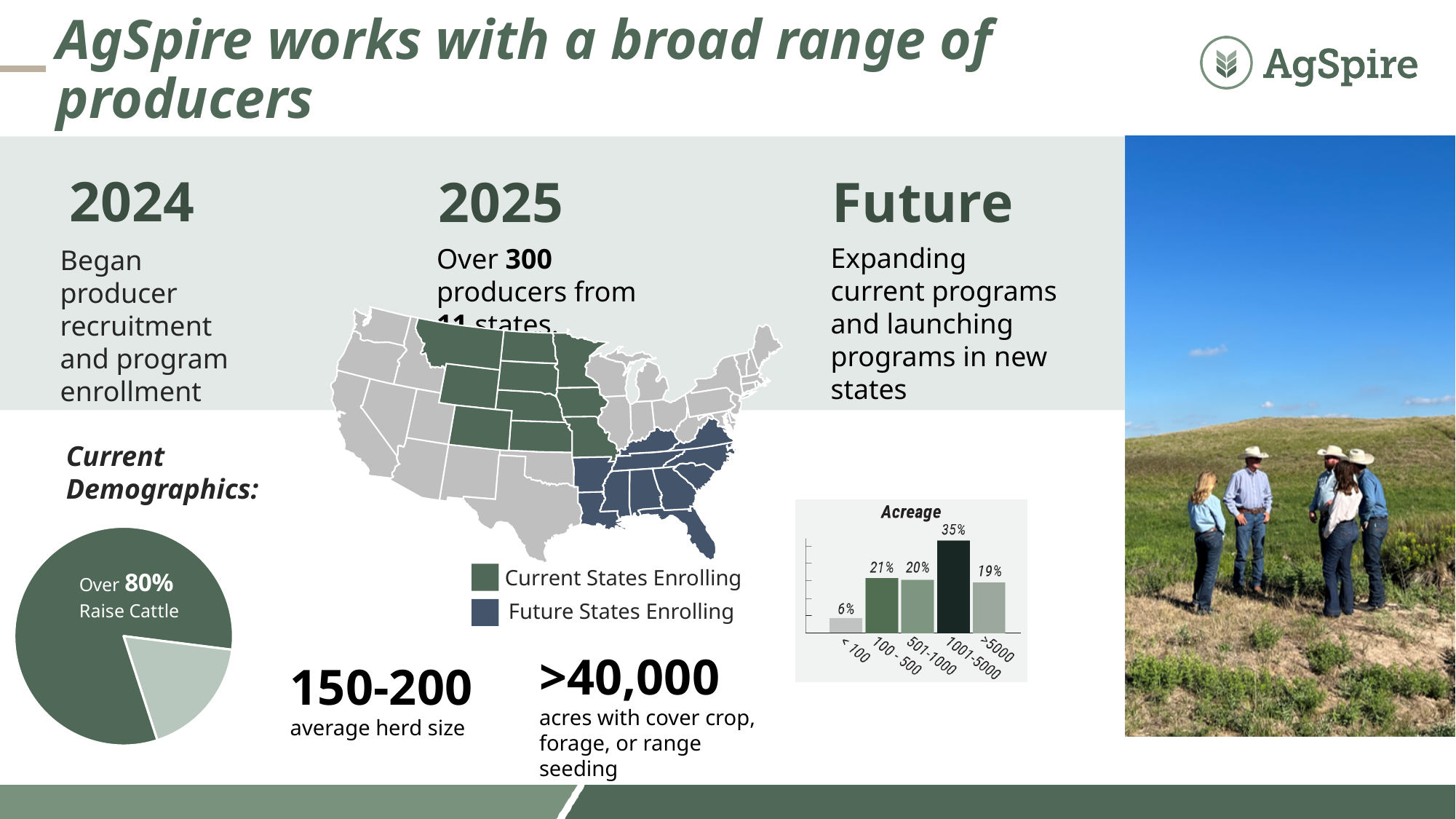
How many categories does the Acreage chart show? 5 In the Acreage chart, what is the difference between the 1001-5000 and 501-1000 values? 15% In the Acreage chart, which category has the highest value? 1001-5000 In the Acreage chart, what is the value for the >5000 category? 19% In the Acreage chart, which is larger, the value for 100 - 500 or the value for >5000? 100 - 500 In the Acreage chart, which category has the lowest value? < 100 In the Acreage chart, what is the value for the < 100 category? 6% In the Acreage chart, what is the value for the 100 - 500 category? 21% What kind of chart is used under Current Demographics to show the share of producers who raise cattle? pie chart In the Acreage chart, what is the value for the 1001-5000 category? 35% What is the title of the bar chart on the slide? Acreage What kind of chart is the Acreage chart? bar chart